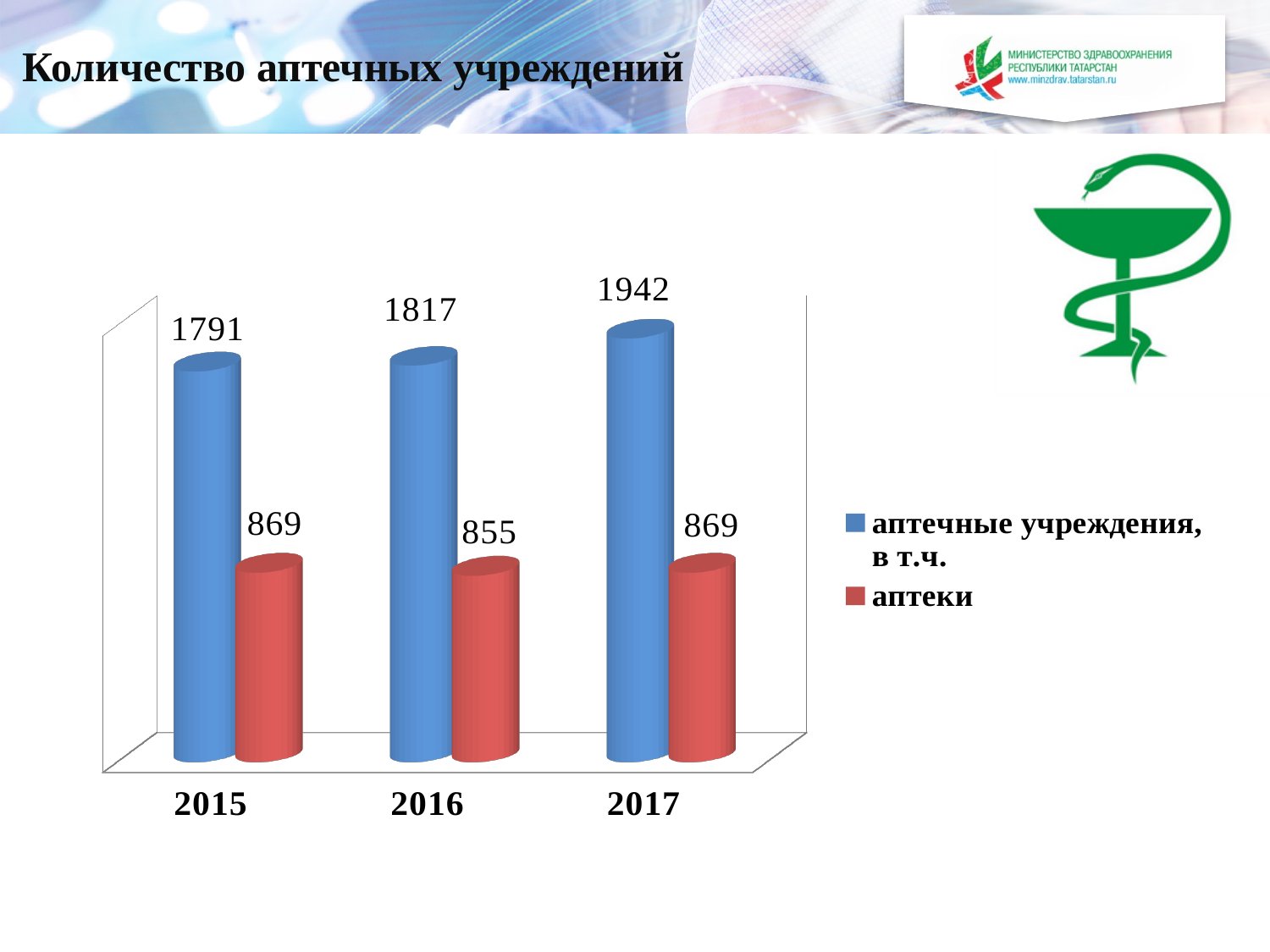
What kind of chart is shown on the slide? bar chart What is the difference between аптечные учреждения, в т.ч. and аптеки in 2015? 922 In which year is the value for аптеки lowest? 2016 Which is larger: аптеки in 2015 or аптеки in 2016? аптеки in 2015 What is the value for аптечные учреждения, в т.ч. in 2015? 1791 Do the values for аптечные учреждения, в т.ч. rise or fall from 2015 to 2017? rise What is the value for аптечные учреждения, в т.ч. in 2017? 1942 How many years are shown on the x axis? 3 How many series does the legend list? 2 What is the value for аптеки in 2016? 855 What is the difference between аптечные учреждения, в т.ч. in 2017 and in 2016? 125 In which year is the value for аптечные учреждения, в т.ч. highest? 2017